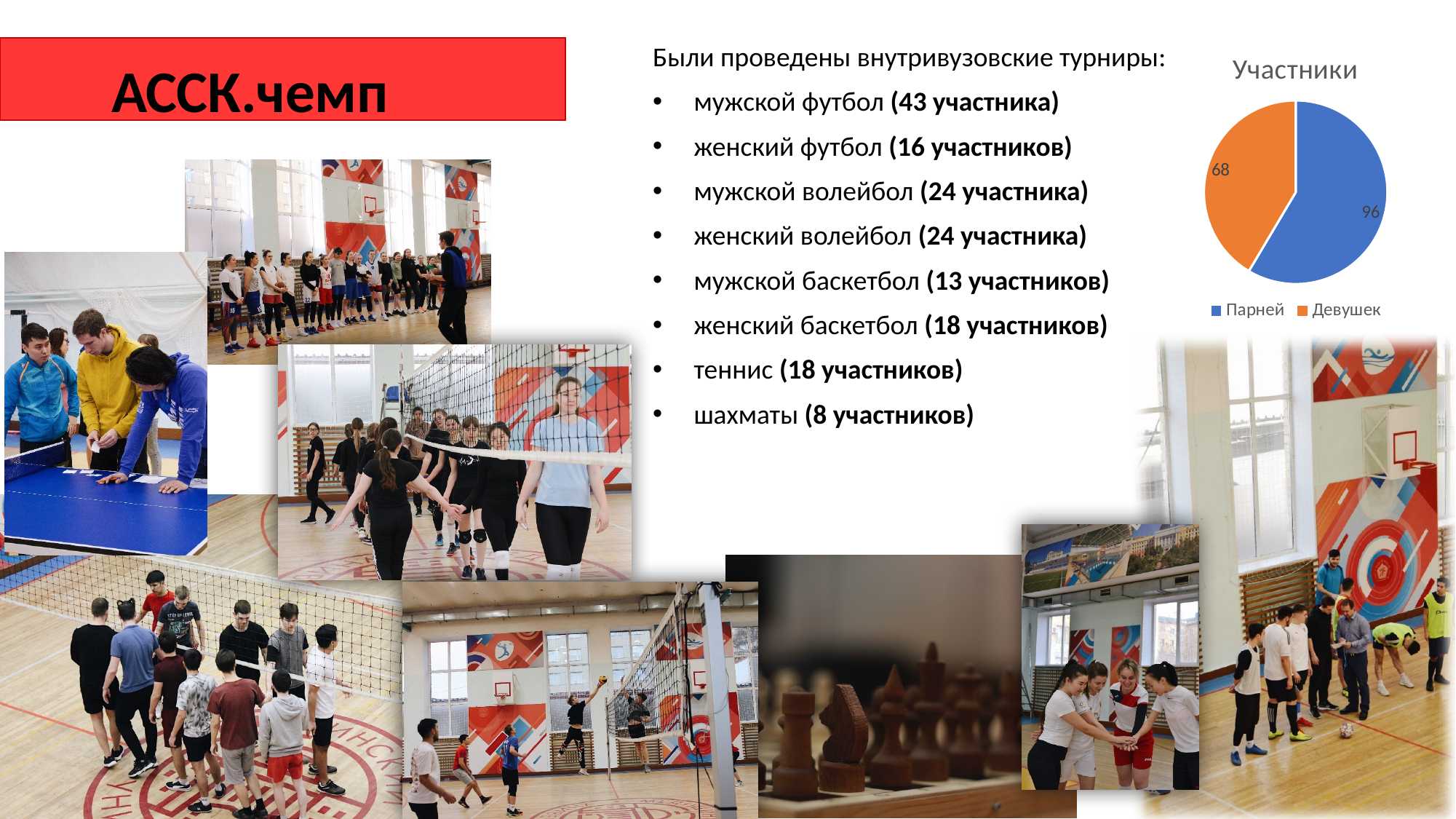
What is the value for "Парней" in the "Участники" chart? 96 Which slice of the "Участники" chart is the largest? Парней Which slice of the "Участники" chart is the smallest? Девушек In the "Участники" chart, which is larger: "Парней" or "Девушек"? Парней How many slices does the "Участники" pie chart have? 2 What type of chart is shown under the title "Участники"? pie chart What is the total of all slices in the "Участники" chart? 164 What is the value for "Девушек" in the "Участники" chart? 68 How many entries does the legend of the "Участники" chart list? 2 Which colour represents "Девушек" in the "Участники" chart? orange What is the difference between the "Парней" and "Девушек" values in the "Участники" chart? 28 What is the title of the chart on the slide? Участники